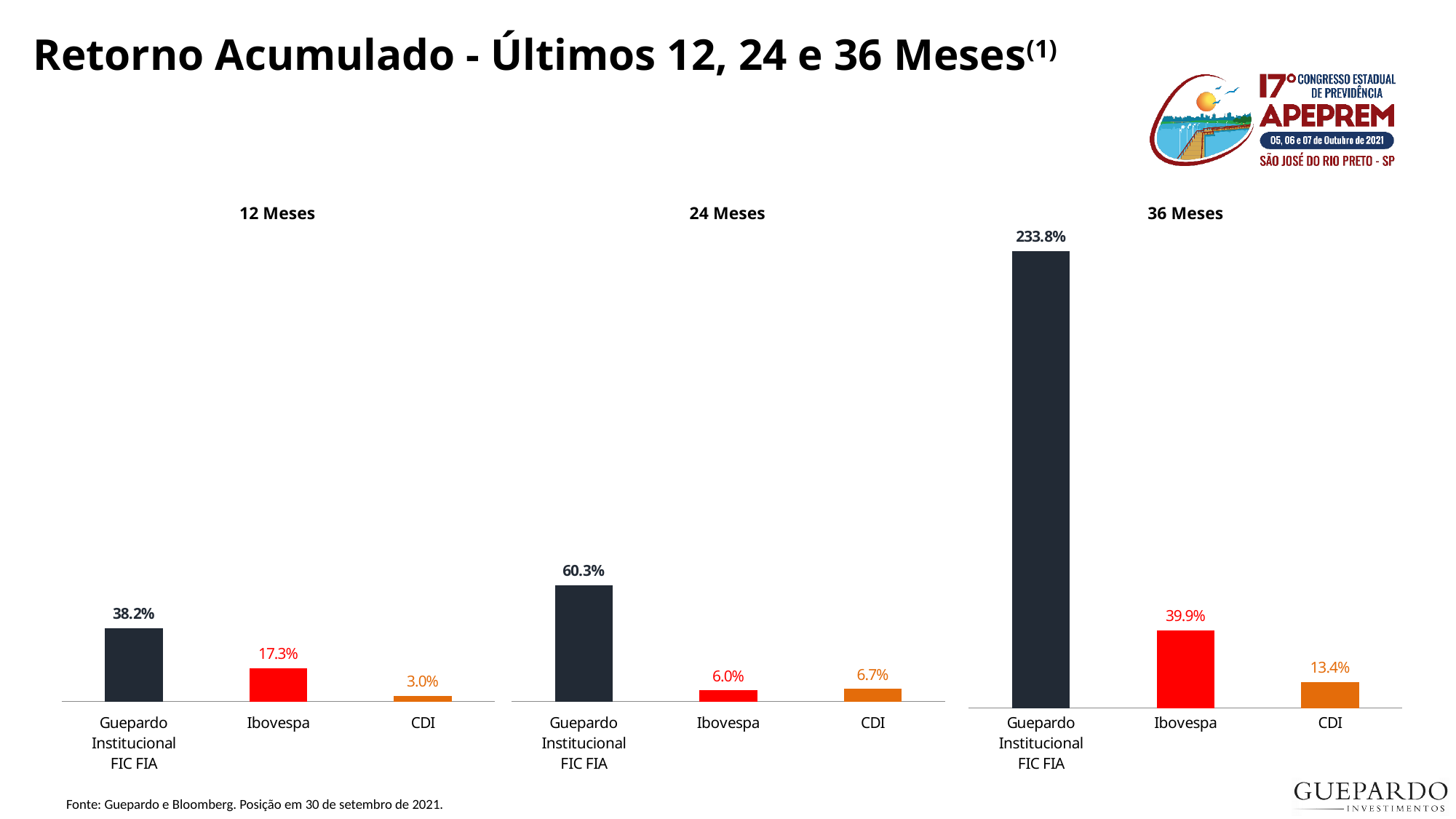
In the 12 Meses chart, what is the value for CDI? 3.0% In the 24 Meses chart, which category has the highest value? Guepardo Institucional FIC FIA What kind of chart is the 36 Meses chart? Bar chart In the 36 Meses chart, what is the value for Guepardo Institucional FIC FIA? 233.8% How many categories are shown in the 12 Meses chart? 3 What colour is the Ibovespa bar in the 24 Meses chart? Red In the 24 Meses chart, what is the value for Ibovespa? 6.0% In the 12 Meses chart, what is the value for Guepardo Institucional FIC FIA? 38.2% In the 12 Meses chart, what is the difference between Guepardo Institucional FIC FIA and Ibovespa? 20.9% In the 24 Meses chart, which is larger, the value for Ibovespa or the value for CDI? CDI In the 36 Meses chart, what is the difference between Ibovespa and CDI? 26.5% In the 36 Meses chart, which category has the lowest value? CDI